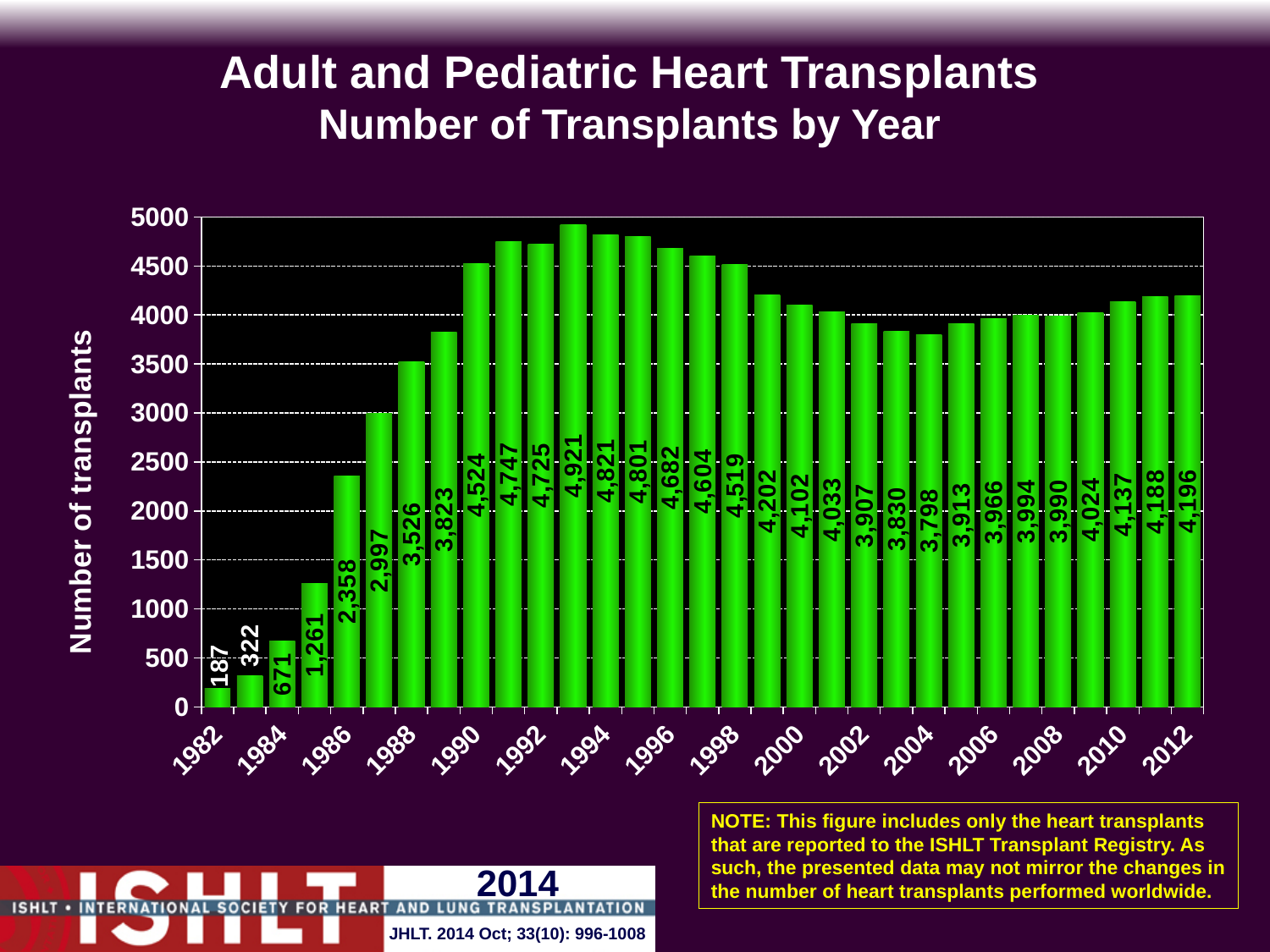
What is the label on the vertical axis of the chart? Number of transplants How many transplants were performed in 1982? 187 What is the number of transplants for 1990? 4,524 Which year has the highest number of transplants? 1993 Is the value for 1988 greater or less than 3500? greater What kind of chart is shown on the slide? bar chart What is the number of transplants for 2012? 4,196 How many bars (years) are plotted in the chart? 31 Which year had more transplants, 1998 or 2008? 1998 What is the number of transplants for 2004? 3,798 Which year has the lowest number of transplants? 1982 What is the difference in the number of transplants between 2012 and 2010? 59